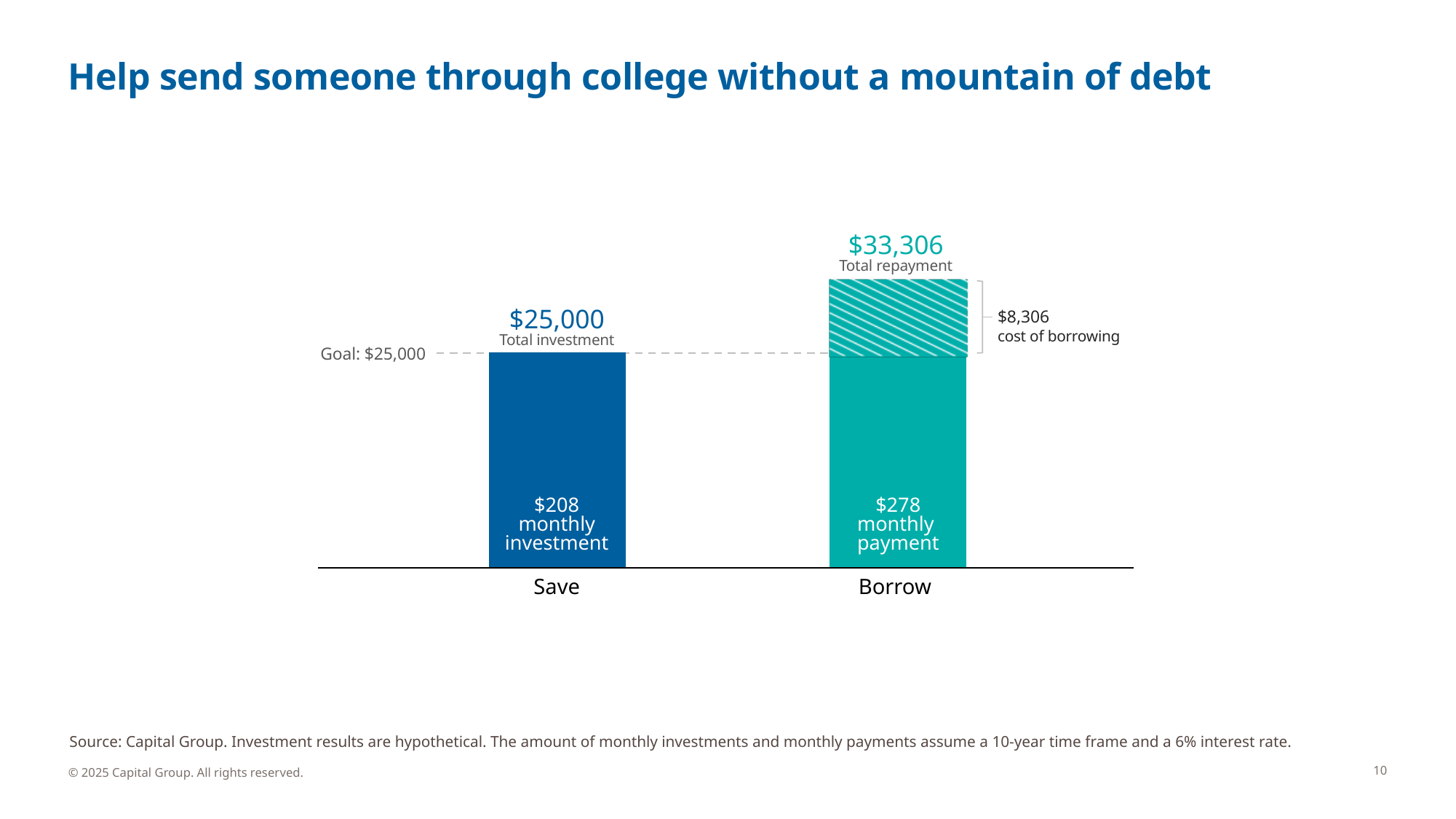
What is the difference between the monthly payment for Borrow and the monthly investment for Save? $70 What is the difference between the Borrow total repayment and the Save total investment? $8,306 What goal amount is marked by the dashed line? $25,000 What is the cost of borrowing shown for the Borrow bar? $8,306 What is the monthly investment shown on the Save bar? $208 How many bars are shown in the chart? 2 What kind of chart is shown on the slide? Bar chart Which bar has the lower total value? Save What is the total repayment for the Borrow bar? $33,306 What is the monthly payment shown on the Borrow bar? $278 What is the total investment for the Save bar? $25,000 Which bar is taller, Save or Borrow? Borrow